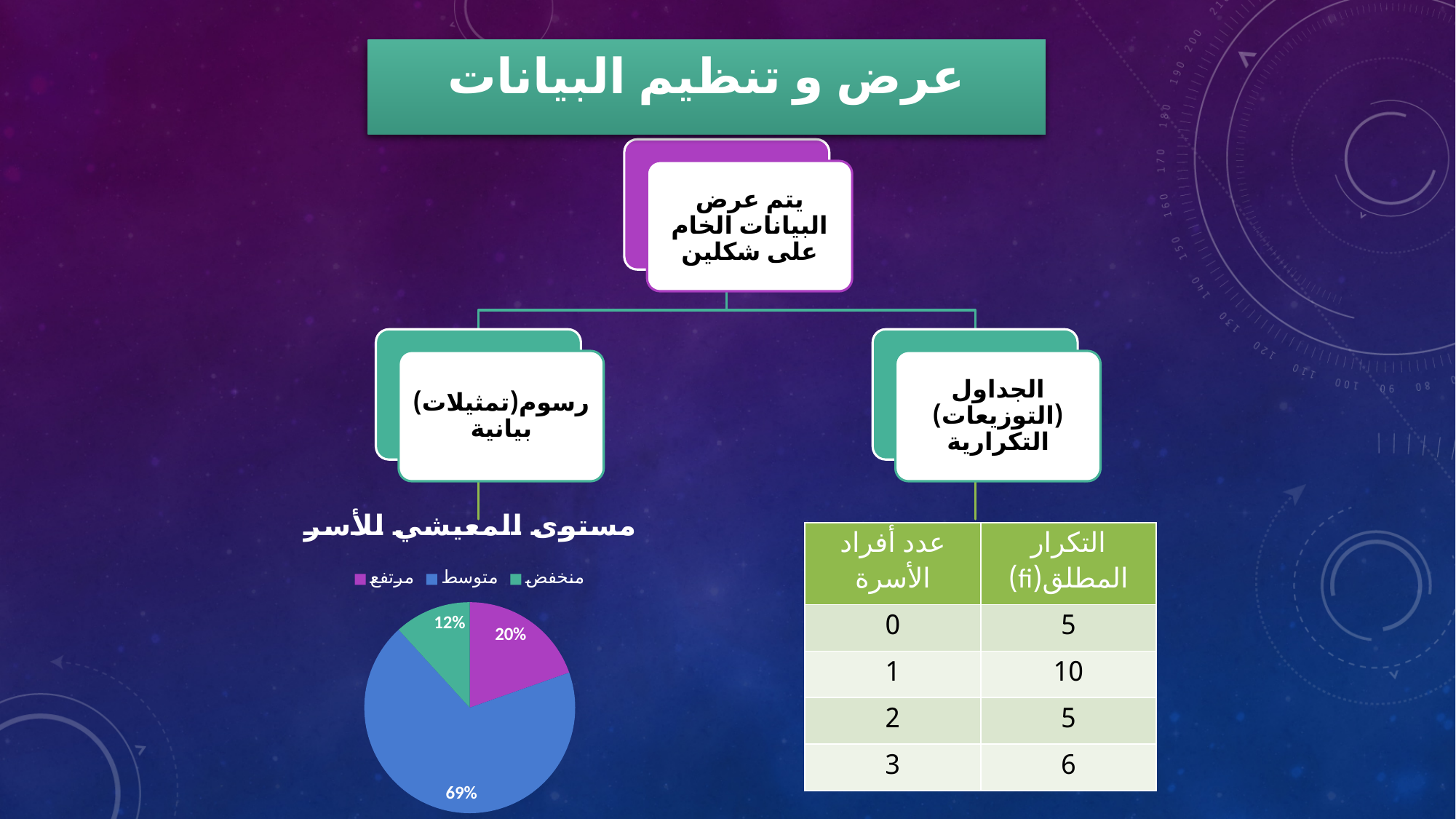
In the pie chart, what is the value for مرتفع? 20% In the pie chart, which is larger: مرتفع or منخفض? مرتفع In the pie chart, what is the difference between the values for متوسط and مرتفع? 49% In the pie chart, what is the value for متوسط? 69% Which category has the smallest slice in the pie chart? منخفض What colour is the متوسط slice in the pie chart? blue What kind of chart is shown on the slide? pie chart How many entries does the pie chart's legend list? 3 In the pie chart, what is the value for منخفض? 12% Which category has the largest slice in the pie chart? متوسط In the pie chart, what is the difference between the values for مرتفع and منخفض? 8% How many slices does the pie chart have? 3